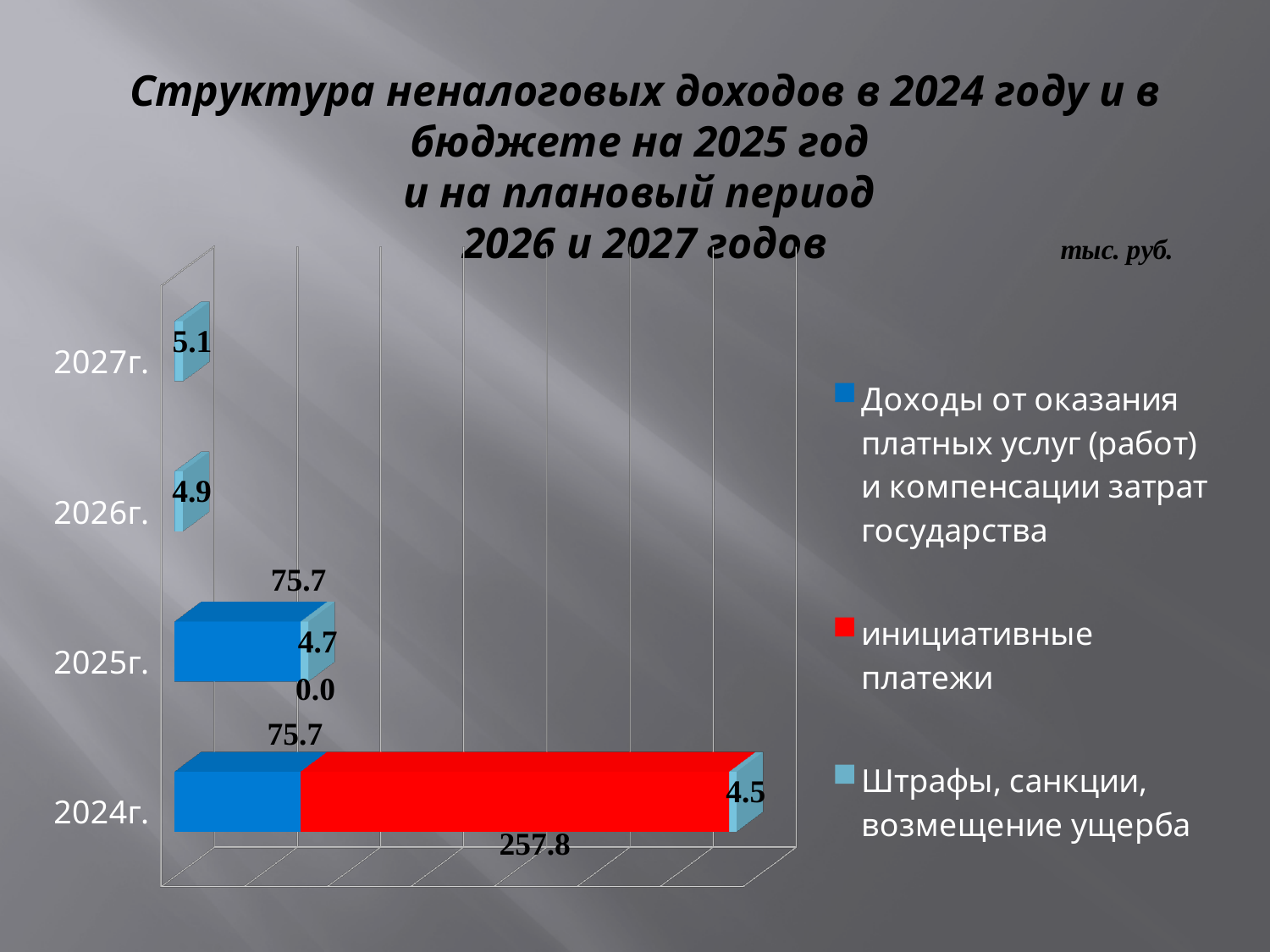
What kind of chart is shown on the slide? Stacked bar chart Which year has the lowest value for Штрафы, санкции, возмещение ущерба? 2024г. What is the value of Штрафы, санкции, возмещение ущерба for 2027г.? 5.1 What is the value of инициативные платежи for 2025г.? 0.0 How many years (categories) are shown on the chart? 4 Which is larger for 2024г.: инициативные платежи or Доходы от оказания платных услуг? инициативные платежи What is the value of Доходы от оказания платных услуг (работ) и компенсации затрат государства for 2025г.? 75.7 What is the value of инициативные платежи for 2024г.? 257.8 Which year has the highest value for Штрафы, санкции, возмещение ущерба? 2027г. What is the difference between инициативные платежи in 2024г. and in 2025г.? 257.8 How many series does the legend list? 3 What is the total of the stacked bar for 2024г.? 338.0